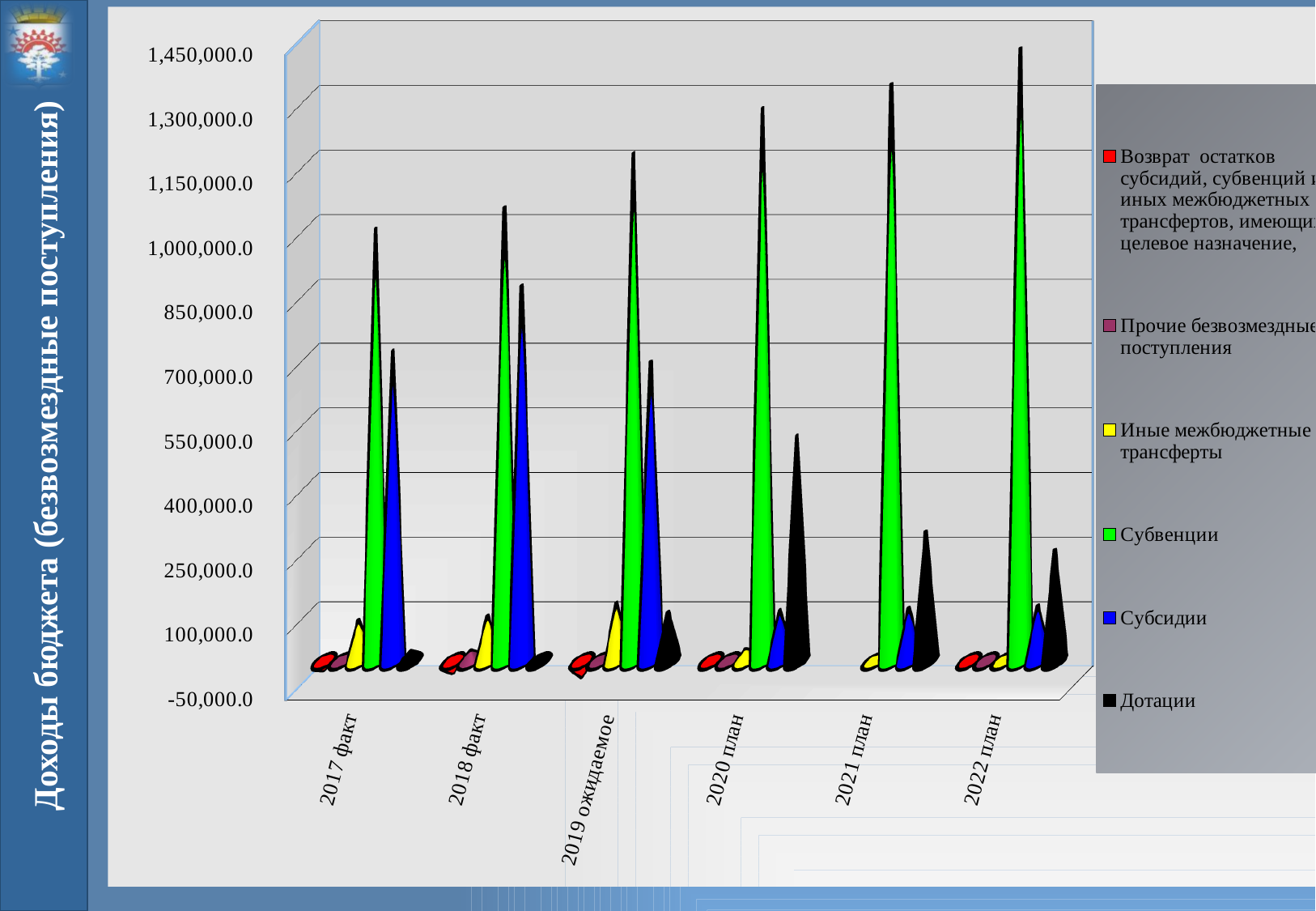
Which category has the highest value for Субвенции? 2022 план How many categories are shown on the x axis of the chart? 6 Do the values for Субвенции rise or fall from 2017 факт to 2022 план? rise Which series has the highest value in the 2017 факт category? Субвенции What colour represents the Субвенции series in the legend? green Is the value for Дотации in 2020 план greater or less than 400,000.0? greater Is the value for Субсидии in 2017 факт greater or less than 550,000.0? greater Which is larger: Субсидии in 2018 факт or Субсидии in 2020 план? Субсидии in 2018 факт Which is larger: Дотации in 2020 план or Дотации in 2017 факт? Дотации in 2020 план Is the value for Субвенции in 2022 план greater or less than 1,300,000.0? greater What kind of chart is shown on the slide? 3D cone chart How many series does the chart legend list? 6